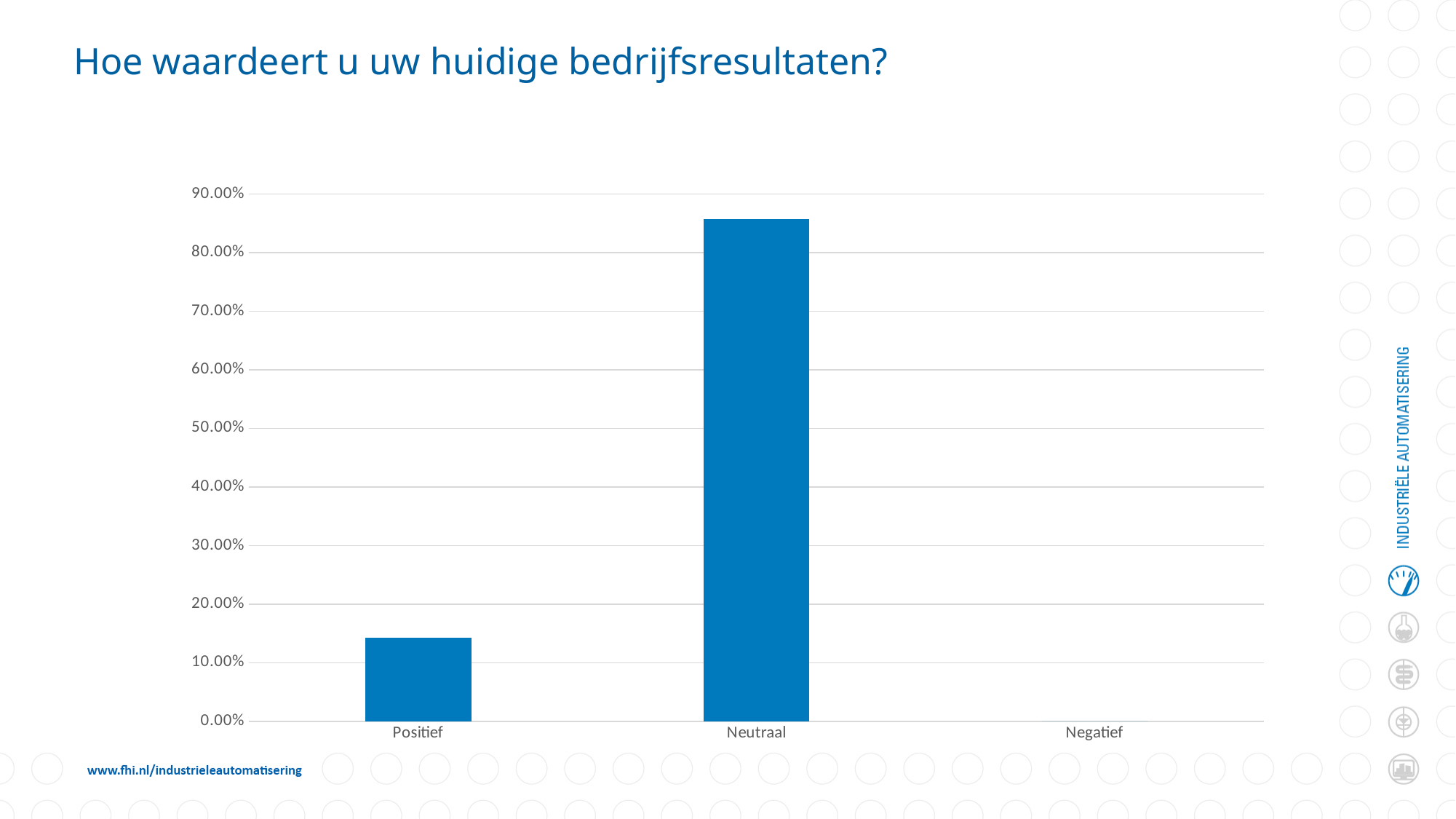
Is the value for Neutraal greater or less than 90.00%? less How many categories are shown on the x axis of the chart? 3 Which category has the lowest value in the chart? Negatief What kind of chart is shown on the slide? bar chart What is the value for Negatief in the chart? 0.00% Is the value for Positief greater or less than 10.00%? greater Is the value for Neutraal greater or less than 80.00%? greater What is the title of the slide containing the chart? Hoe waardeert u uw huidige bedrijfsresultaten? What is the highest value shown on the y axis of the chart? 90.00% Which is larger, the value for Positief or the value for Neutraal? Neutraal Which category has the highest value in the chart? Neutraal